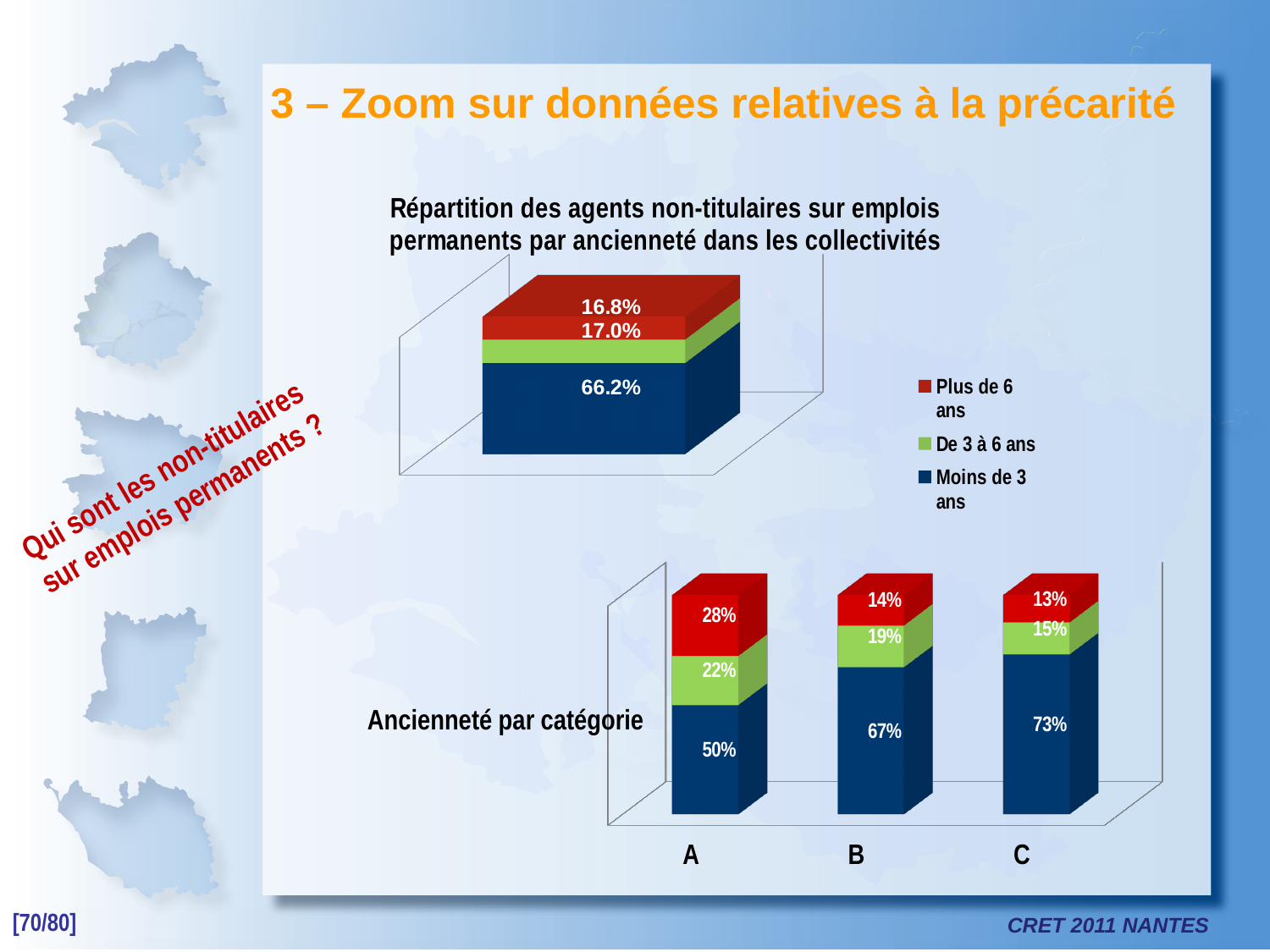
In the bottom chart 'Ancienneté par catégorie', what is the value for 'Plus de 6 ans' in category A? 28% In the bottom chart 'Ancienneté par catégorie', which category has the highest value for 'Moins de 3 ans'? C In the bottom chart 'Ancienneté par catégorie', what is the value for 'Moins de 3 ans' in category B? 67% In the bottom chart 'Ancienneté par catégorie', what is the value for 'De 3 à 6 ans' in category C? 15% In the top chart 'Répartition des agents non-titulaires sur emplois permanents par ancienneté dans les collectivités', what is the difference between 'De 3 à 6 ans' and 'Plus de 6 ans'? 0.2% In the top chart 'Répartition des agents non-titulaires sur emplois permanents par ancienneté dans les collectivités', what is the value for 'Plus de 6 ans'? 16.8% In the bottom chart 'Ancienneté par catégorie', what is the difference between the 'Moins de 3 ans' values for categories C and A? 23% In the top chart 'Répartition des agents non-titulaires sur emplois permanents par ancienneté dans les collectivités', what is the value for 'Moins de 3 ans'? 66.2% In the top chart 'Répartition des agents non-titulaires sur emplois permanents par ancienneté dans les collectivités', which segment is the largest? Moins de 3 ans How many series does the legend list? 3 In the bottom chart 'Ancienneté par catégorie', which category has the lowest value for 'Plus de 6 ans'? C In the bottom chart 'Ancienneté par catégorie', how many categories are shown on the x axis? 3